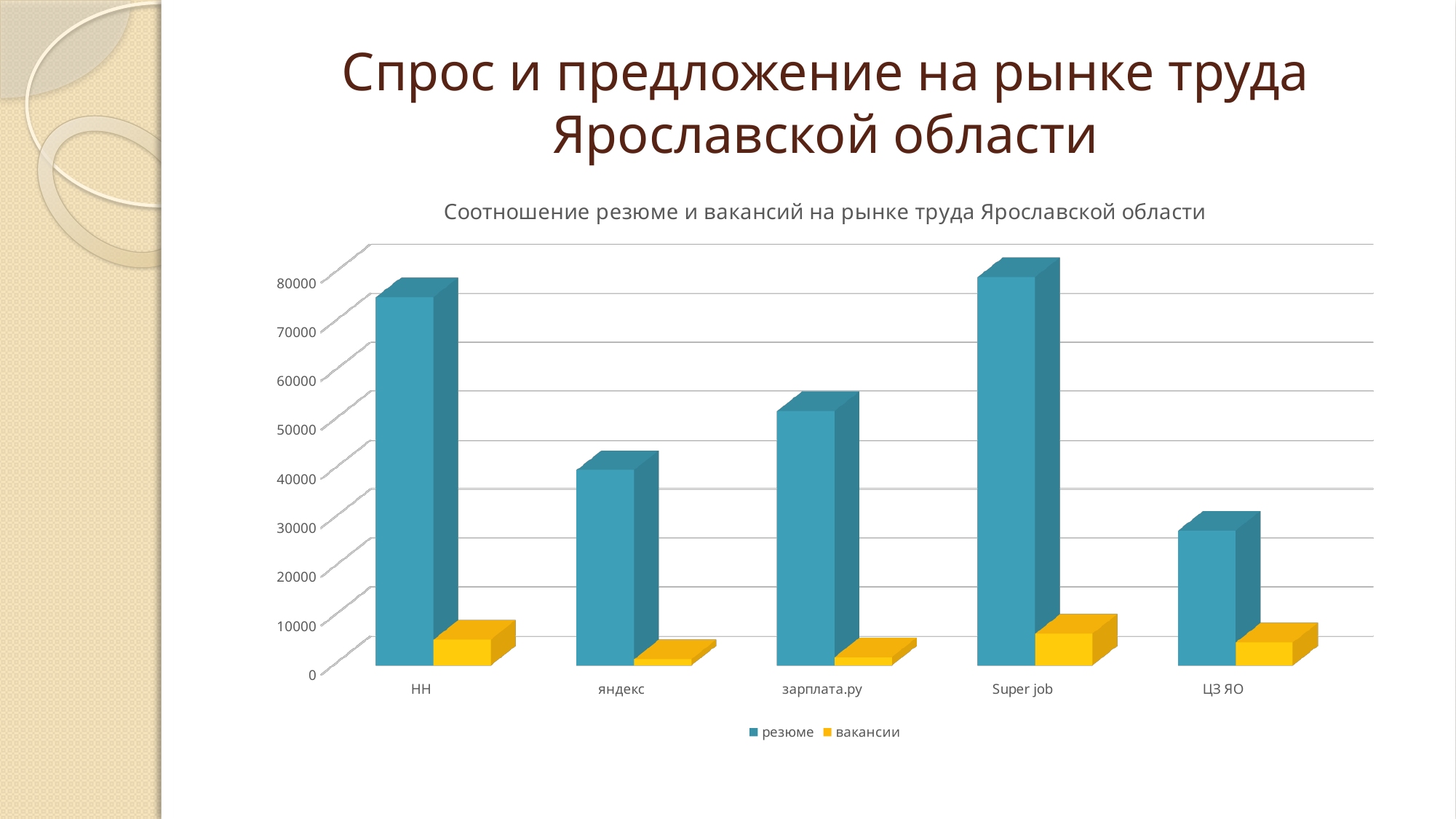
What kind of chart is shown on the slide? bar chart How many series does the chart legend list? 2 Which category has the highest value for резюме? Super job Is the резюме value for яндекс greater or less than 50000? less Is the вакансии value for Super job greater or less than 20000? less Is the резюме value for ЦЗ ЯО greater or less than 40000? less What is the title of the chart? Соотношение резюме и вакансий на рынке труда Ярославской области Which category has the lowest value for резюме? ЦЗ ЯО How many categories are shown on the x axis of the chart? 5 Which is larger, the резюме value for HH or for яндекс? HH Which is larger, the резюме value for зарплата.ру or for ЦЗ ЯО? зарплата.ру